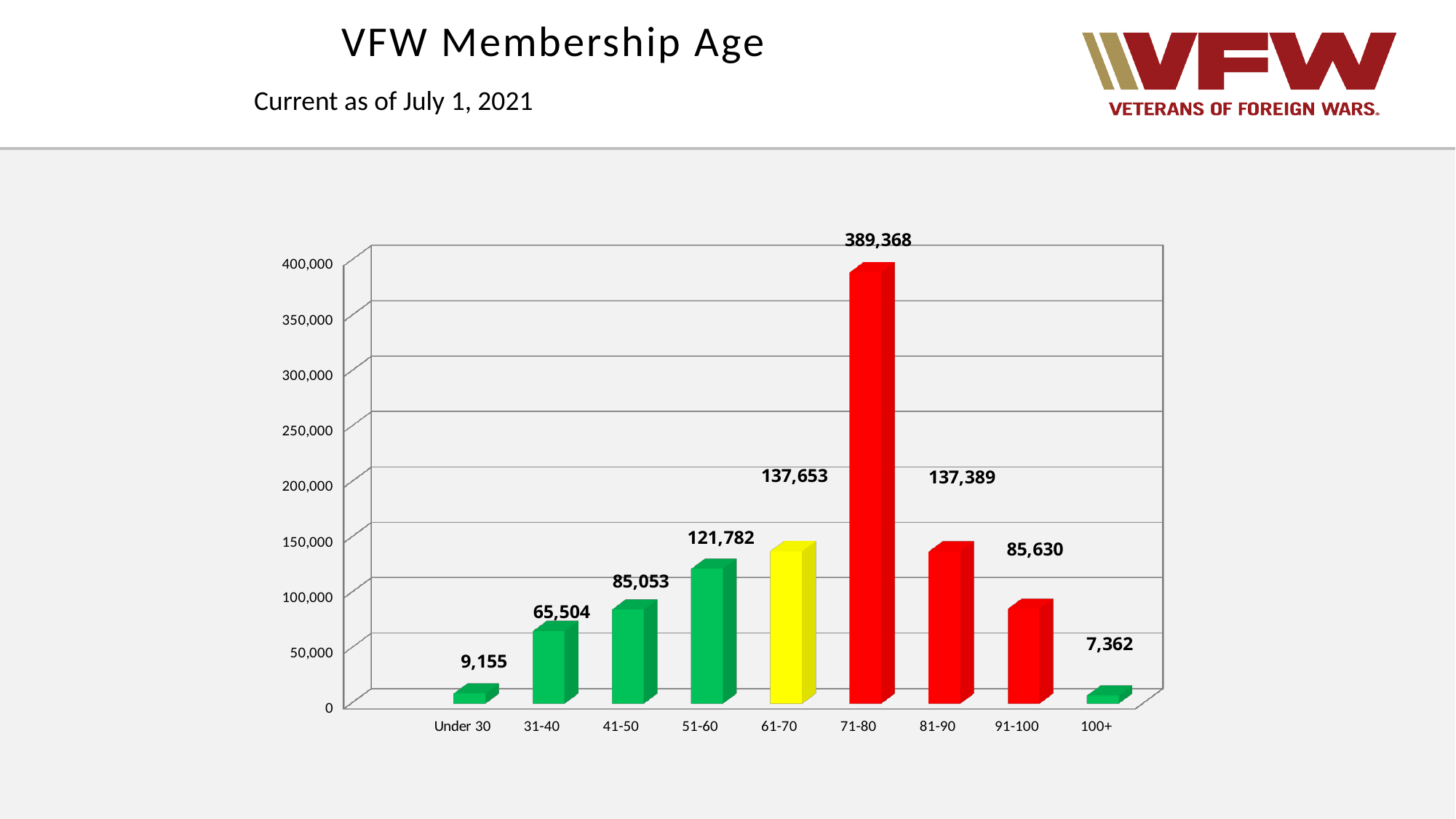
What is the difference between the 71-80 and 61-70 membership values? 251,715 Is the value for the 51-60 age group greater or less than 100,000? greater What kind of chart is shown on the slide? bar chart Which age group has the lowest membership? 100+ How many age categories are shown on the x axis? 9 What is the membership value for the Under 30 age group? 9,155 What colour is the bar for the 61-70 age group? yellow What is the difference between the 61-70 and 81-90 membership values? 264 Which is larger, the membership for 31-40 or for 41-50? 41-50 What is the membership value for the 51-60 age group? 121,782 What is the membership value for the 91-100 age group? 85,630 Which age group has the highest membership? 71-80